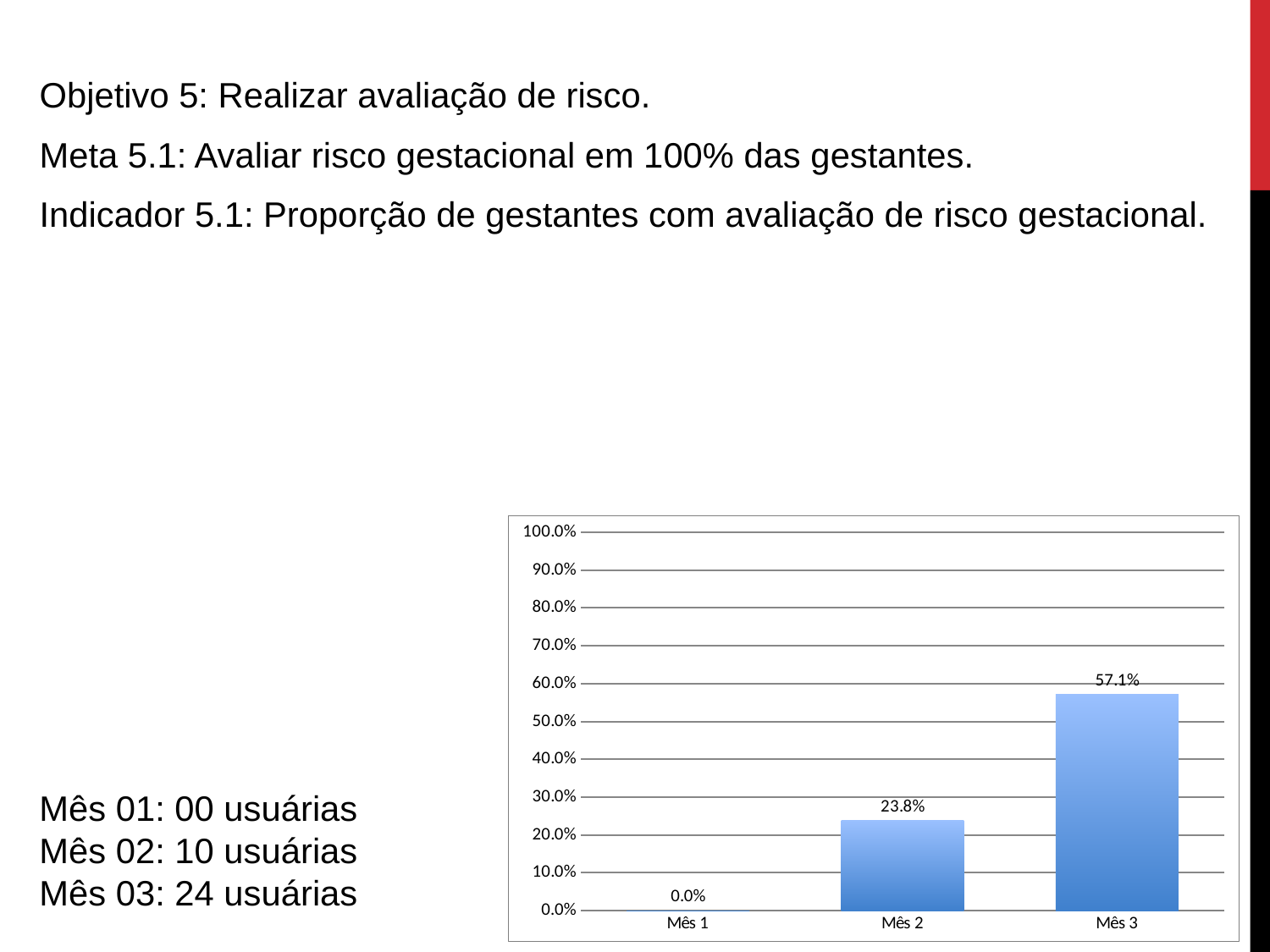
What is the highest value shown on the y axis? 100.0% Do the values rise or fall from Mês 1 to Mês 3? rise What is the value for Mês 3? 57.1% Which month has the highest value? Mês 3 How many months are shown on the x axis? 3 Which month has the lowest value? Mês 1 Is the value for Mês 3 greater or less than 50.0%? greater What is the difference between the values for Mês 3 and Mês 2? 33.3% What is the value for Mês 2? 23.8% What is the value for Mês 1? 0.0% Which is larger, the value for Mês 2 or the value for Mês 3? Mês 3 What kind of chart is shown on the slide? bar chart